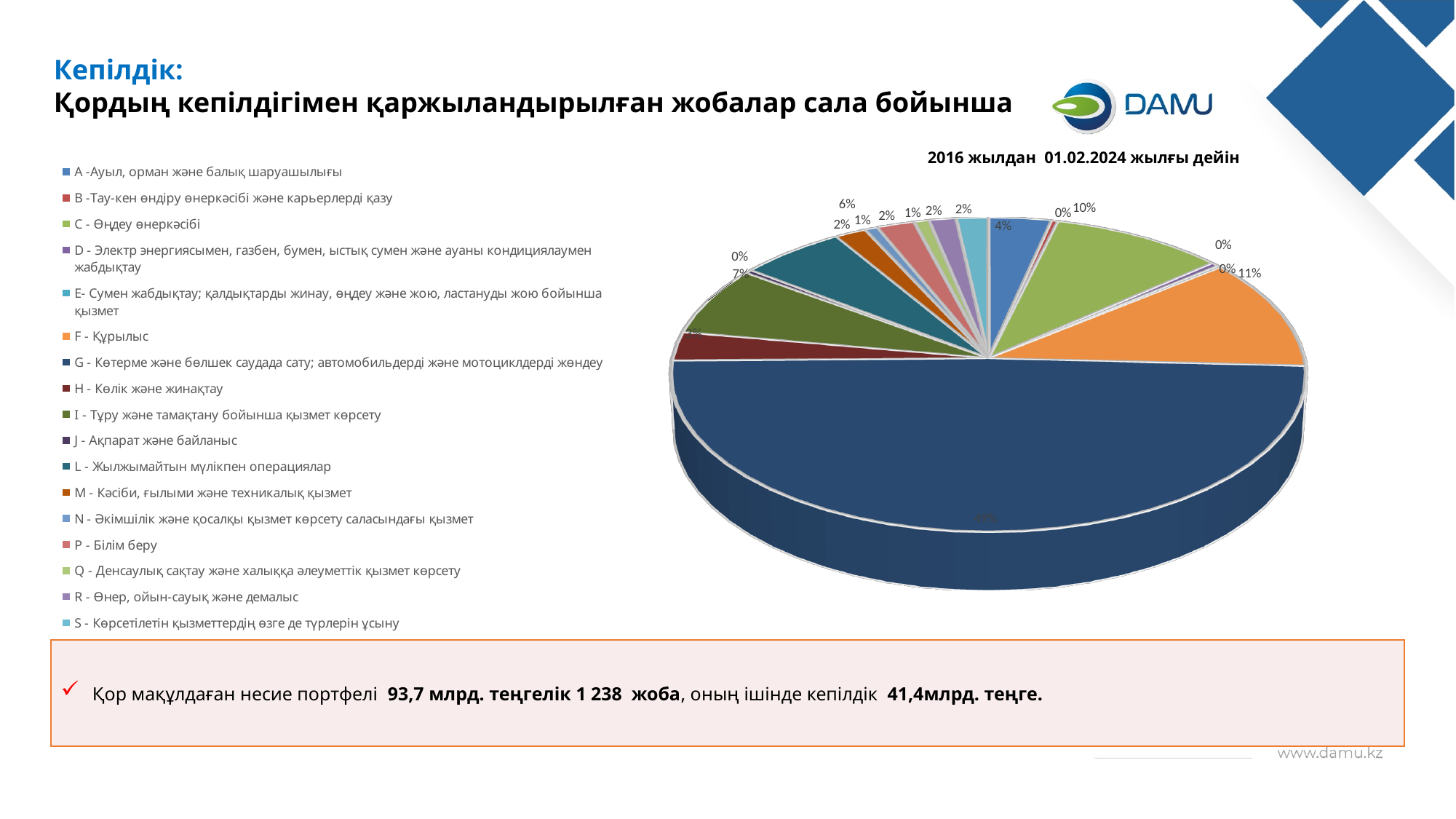
How many entries does the legend of the pie chart list? 17 What kind of chart is shown on the slide? pie chart Which is larger in the pie chart: the share for C - Өңдеу өнеркәсібі or the share for F - Құрылыс? F - Құрылыс What share of the pie does sector C - Өңдеу өнеркәсібі have? 10% What share of the pie does sector L - Жылжымайтын мүлікпен операциялар have? 6% What share of the pie does sector A - Ауыл, орман және балық шаруашылығы have? 4% What is the difference between the share for F - Құрылыс and the share for C - Өңдеу өнеркәсібі? 1% Which sector has the largest slice in the pie chart? G - Көтерме және бөлшек саудада сату; автомобильдерді және мотоциклдерді жөндеу What period does the pie chart cover, according to the label above it? 2016 жылдан 01.02.2024 жылғы дейін What share of the pie does sector F - Құрылыс have? 11% What share of the pie does sector I - Тұру және тамақтану бойынша қызмет көрсету have? 7% What is the first entry listed in the pie chart's legend? A - Ауыл, орман және балық шаруашылығы